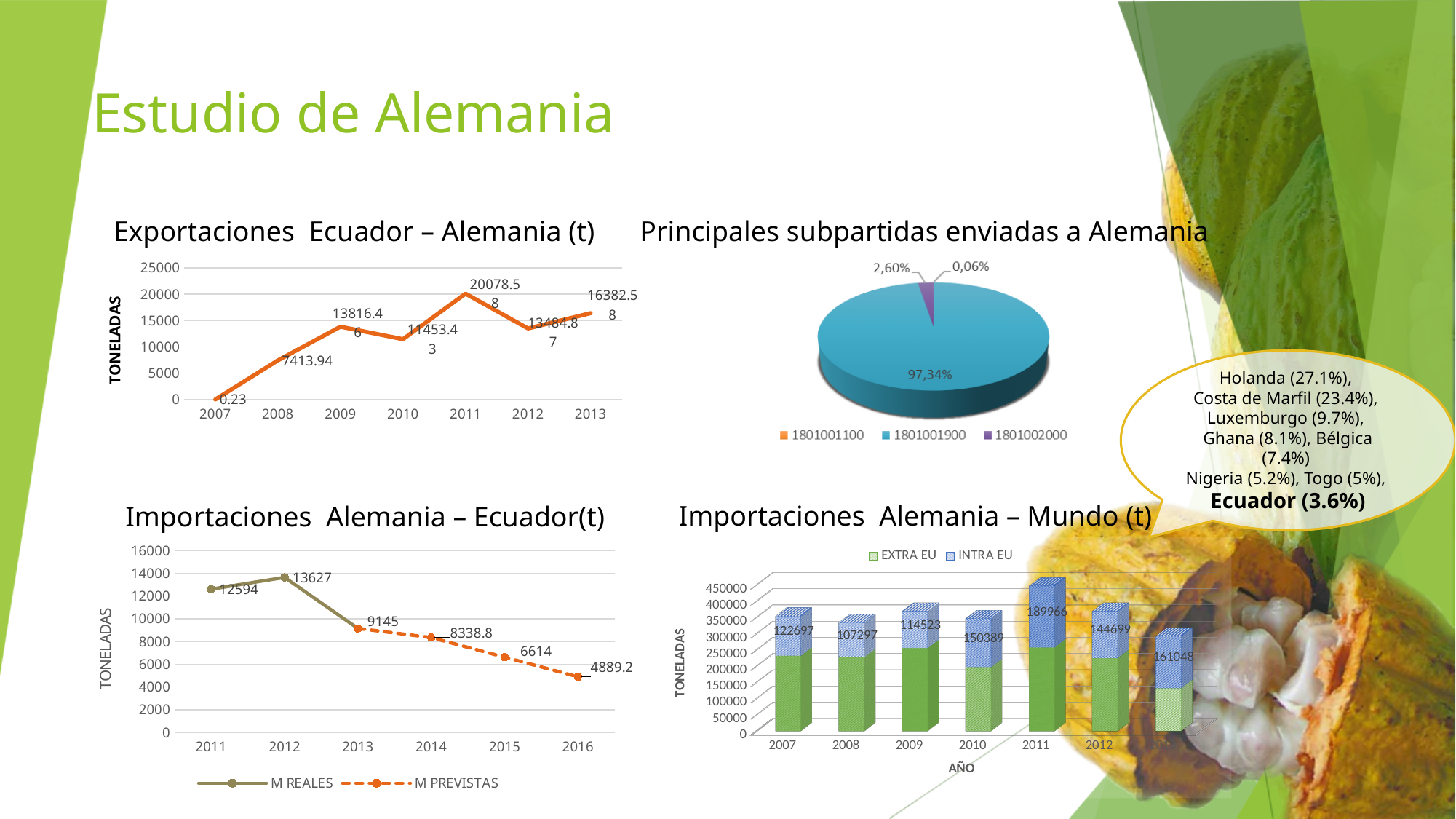
In the 'Exportaciones Ecuador – Alemania (t)' chart, which year has the highest value? 2011 What kind of chart is 'Importaciones Alemania – Mundo (t)'? Bar chart In the 'Principales subpartidas enviadas a Alemania' pie chart, how many subpartidas does the legend list? 3 In the 'Importaciones Alemania – Ecuador(t)' chart, what is the M REALES value for 2012? 13627 In the 'Exportaciones Ecuador – Alemania (t)' chart, which year has the lowest value? 2007 What kind of chart is 'Principales subpartidas enviadas a Alemania'? Pie chart In the 'Importaciones Alemania – Ecuador(t)' chart, do the M PREVISTAS values rise or fall from 2013 to 2016? Fall In the 'Importaciones Alemania – Ecuador(t)' chart, what is the difference between the 2011 and 2012 M REALES values? 1033 In the 'Importaciones Alemania – Ecuador(t)' chart, what is the M PREVISTAS value for 2016? 4889.2 In the 'Principales subpartidas enviadas a Alemania' pie chart, what share does subpartida 1801001900 have? 97,34% In the 'Exportaciones Ecuador – Alemania (t)' chart, what was the export value in 2008? 7413.94 In the 'Exportaciones Ecuador – Alemania (t)' chart, how many years are plotted on the x axis? 7